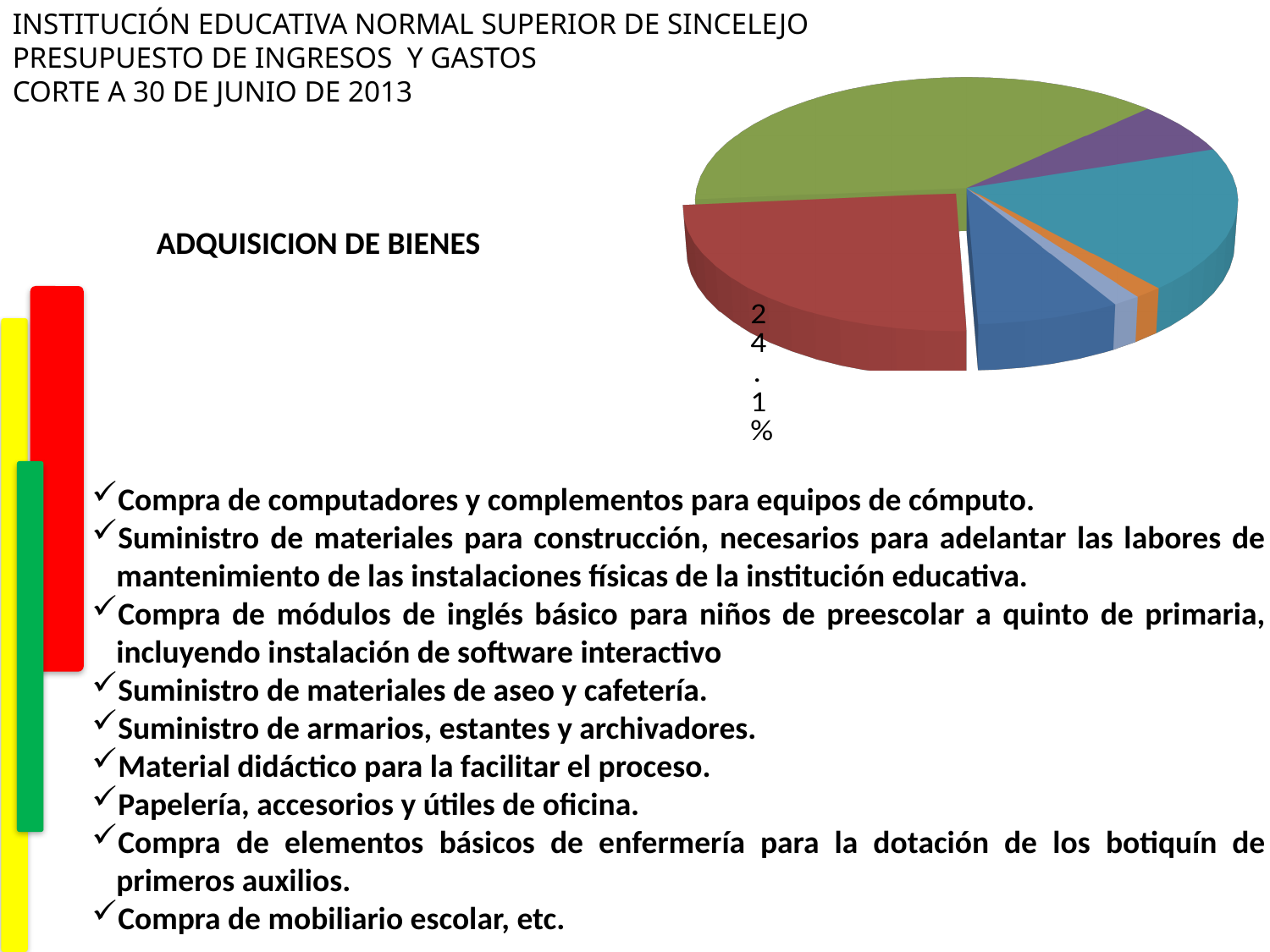
What kind of chart is shown on the slide? pie chart What share of the pie does the exploded red slice represent? 24.1% Which is larger, the red slice or the dark blue slice? the red slice What percentage value is printed on the pie chart? 24.1% Which is larger, the green slice or the red slice? the green slice Does the pie chart have a legend? No Which slice of the pie chart is the largest? the green slice Which slice of the pie chart is pulled out (exploded) from the rest? the red slice How many slices does the pie chart have? 7